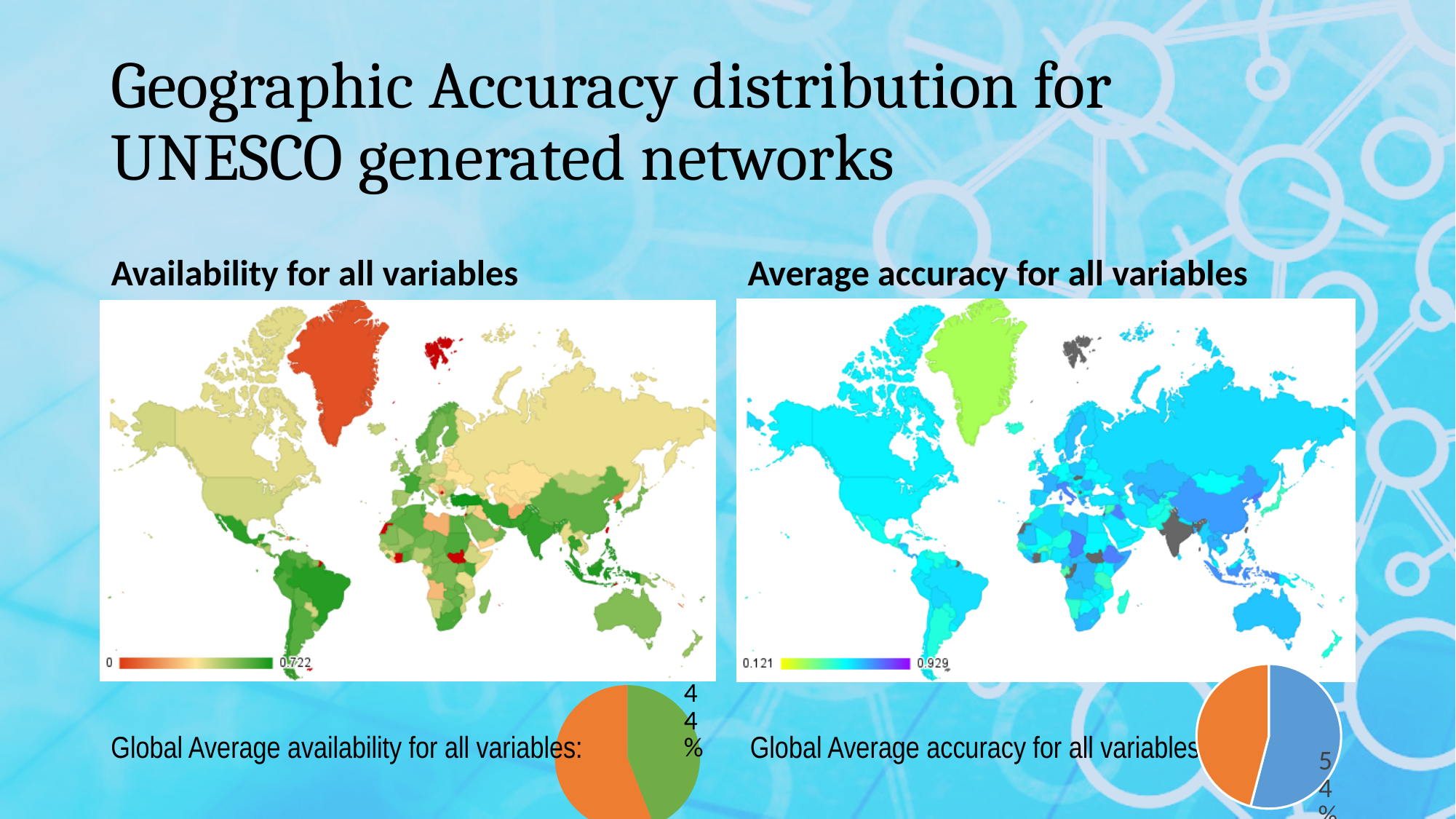
In the pie chart next to 'Global Average availability for all variables', is the labelled slice's value greater or less than 50%? less What kind of chart is shown next to 'Global Average availability for all variables'? pie chart In the pie chart next to 'Global Average availability for all variables', what percentage is printed on the labelled slice? 44% In the pie chart next to 'Global Average accuracy for all variables', what percentage is printed on the labelled slice? 54% How many slices does the pie chart next to 'Global Average availability for all variables' have? 2 In the pie chart next to 'Global Average accuracy for all variables', which slice is larger, the blue one or the orange one? blue On the 'Availability for all variables' map, what is the maximum value shown on the colour scale? 0.722 On the 'Average accuracy for all variables' map, what is the minimum value shown on the colour scale? 0.121 In the pie chart next to 'Global Average availability for all variables', which slice is larger, the green one or the orange one? orange How many slices does the pie chart next to 'Global Average accuracy for all variables' have? 2 In the pie chart next to 'Global Average accuracy for all variables', is the labelled slice's value greater or less than 50%? greater